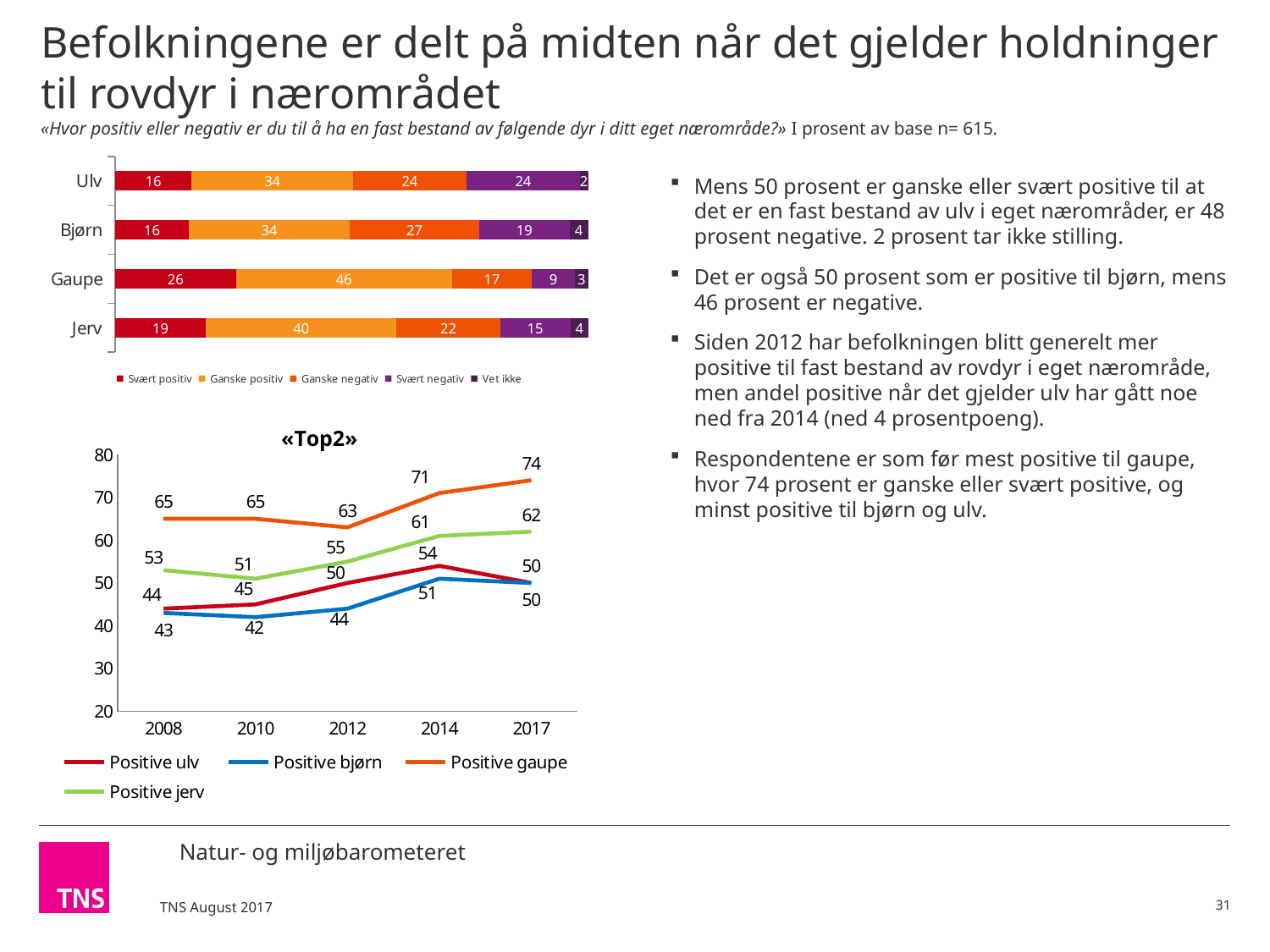
In the «Top2» chart, which series has the lowest value in 2012? Positive bjørn In the stacked bar chart at the top left, what is the difference between the 'Ganske negativ' values for Bjørn and Gaupe? 10 In the stacked bar chart at the top left, how many animals are shown? 4 In the stacked bar chart at the top left, what is the value for 'Svært negativ' for Ulv? 24 What type of chart is the «Top2» chart? line chart In the «Top2» chart, what is the difference between Positive gaupe and Positive ulv in 2014? 17 In the «Top2» chart, what is the value for Positive bjørn in 2010? 42 In the «Top2» chart, does Positive jerv rise or fall from 2012 to 2017? rise In the «Top2» chart, what is the value for Positive gaupe in 2017? 74 In the stacked bar chart at the top left, which animal has the highest 'Svært positiv' value? Gaupe In the stacked bar chart at the top left, how many series does the legend list? 5 In the stacked bar chart at the top left, what is the value for 'Ganske positiv' for Gaupe? 46